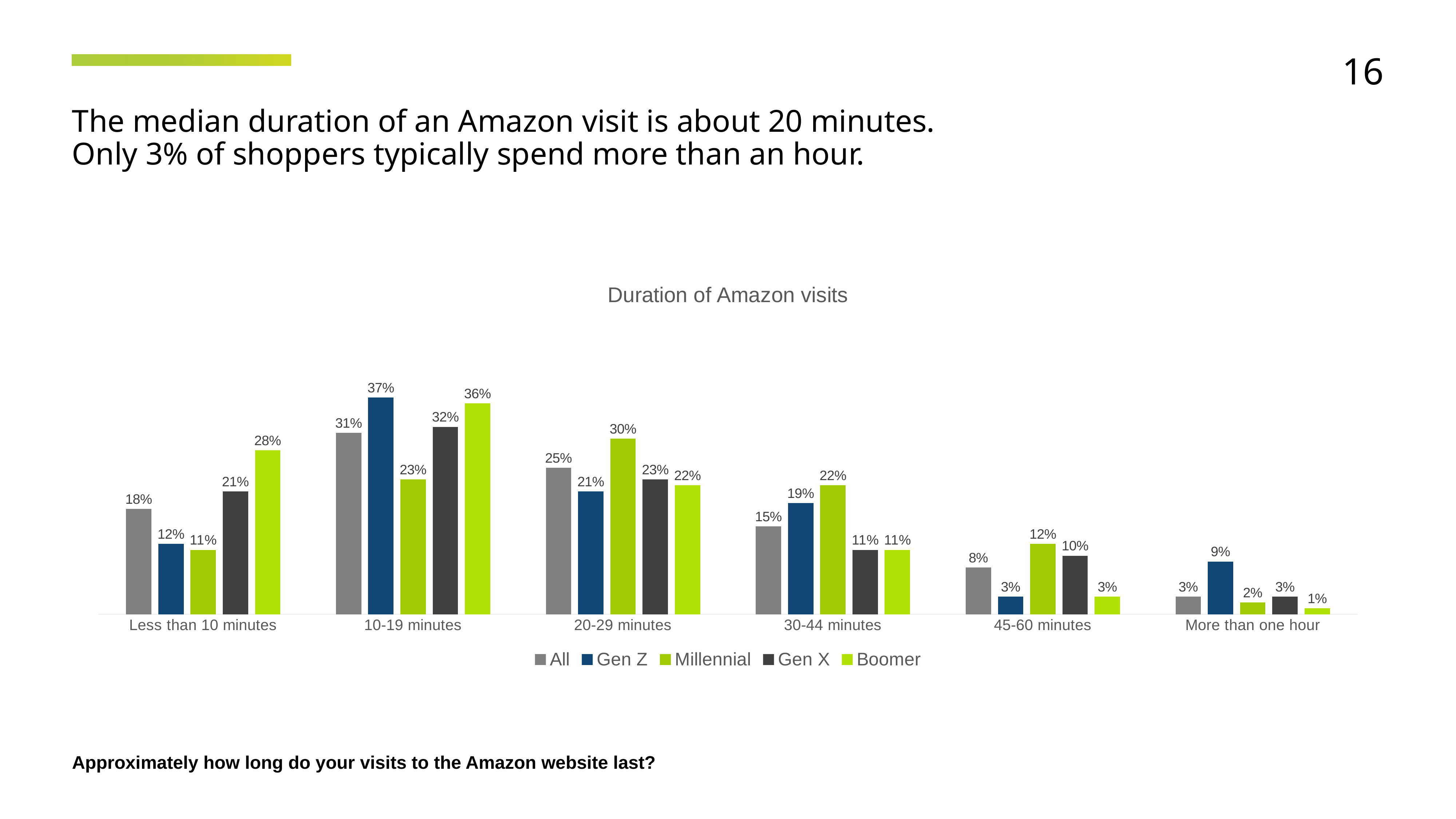
What is the difference between the Gen Z and Millennial values in the 10-19 minutes category? 14% What is the value for Millennial in the 20-29 minutes category? 30% In the 45-60 minutes category, which is larger: Millennial or Gen X? Millennial How many duration categories are shown on the x axis? 6 Which category has the highest value for the All series? 10-19 minutes What kind of chart is shown on the slide? Bar chart How many series does the legend list? 5 What is the value for All in the More than one hour category? 3% What is the value for Boomer in the Less than 10 minutes category? 28% What is the value for Gen Z in the 10-19 minutes category? 37% Which category has the lowest value for the Boomer series? More than one hour What is the title of the chart? Duration of Amazon visits